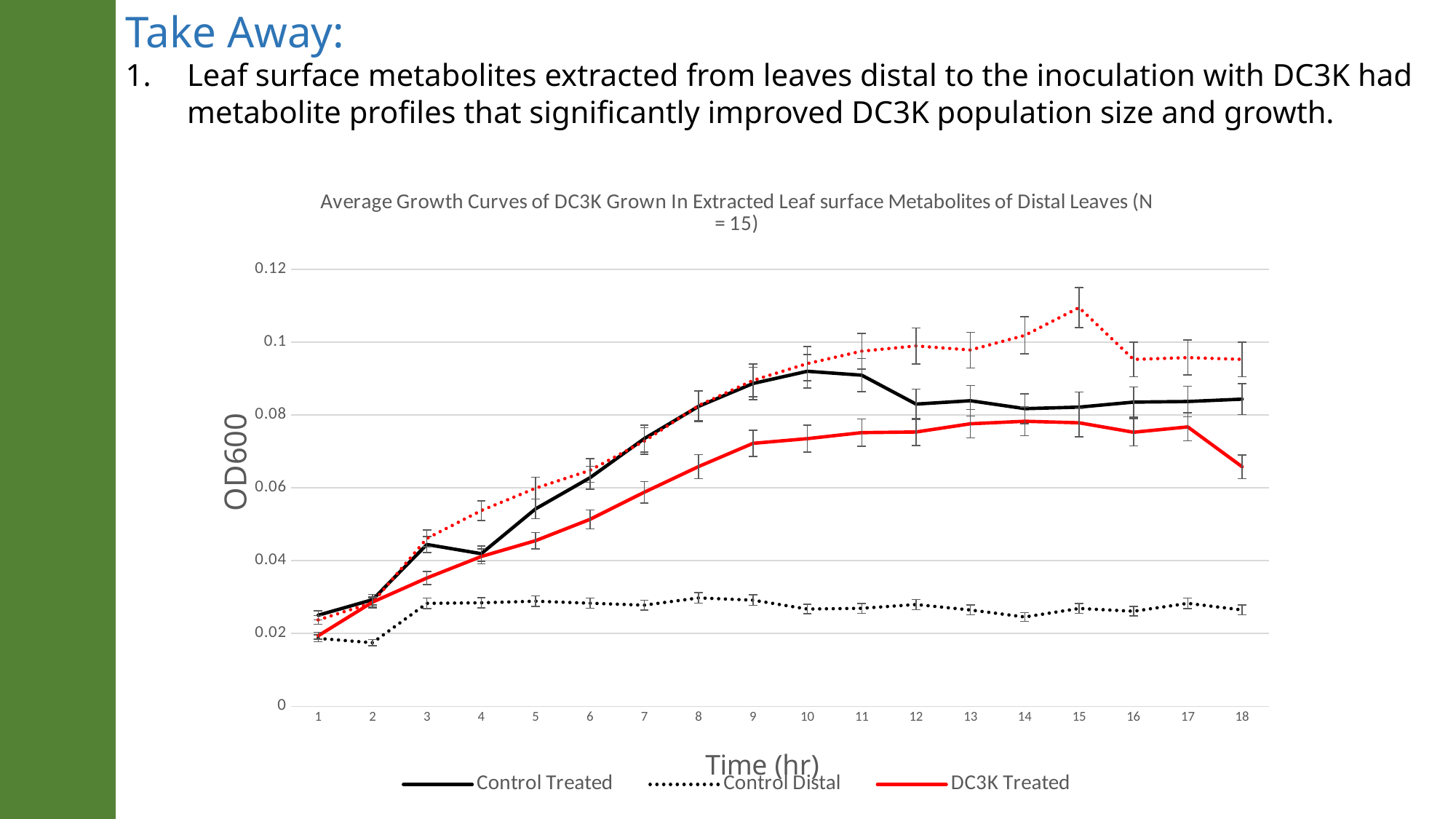
Is the value for Control Distal at hour 10 greater or less than 0.04? less At hour 10, which series has the higher value: Control Treated or DC3K Treated? Control Treated Is the value for DC3K Treated at hour 9 greater or less than 0.06? greater Does the DC3K Treated series rise or fall between hour 1 and hour 9? rise What is the label on the y axis? OD600 What kind of chart is shown on the slide? line chart How many series does the legend list? 3 Which legend series has the lowest value at hour 12? Control Distal How many time points are plotted along the x axis? 18 At hour 18, which series has the higher value: Control Treated or DC3K Treated? Control Treated Is the value for Control Treated at hour 10 greater or less than 0.08? greater